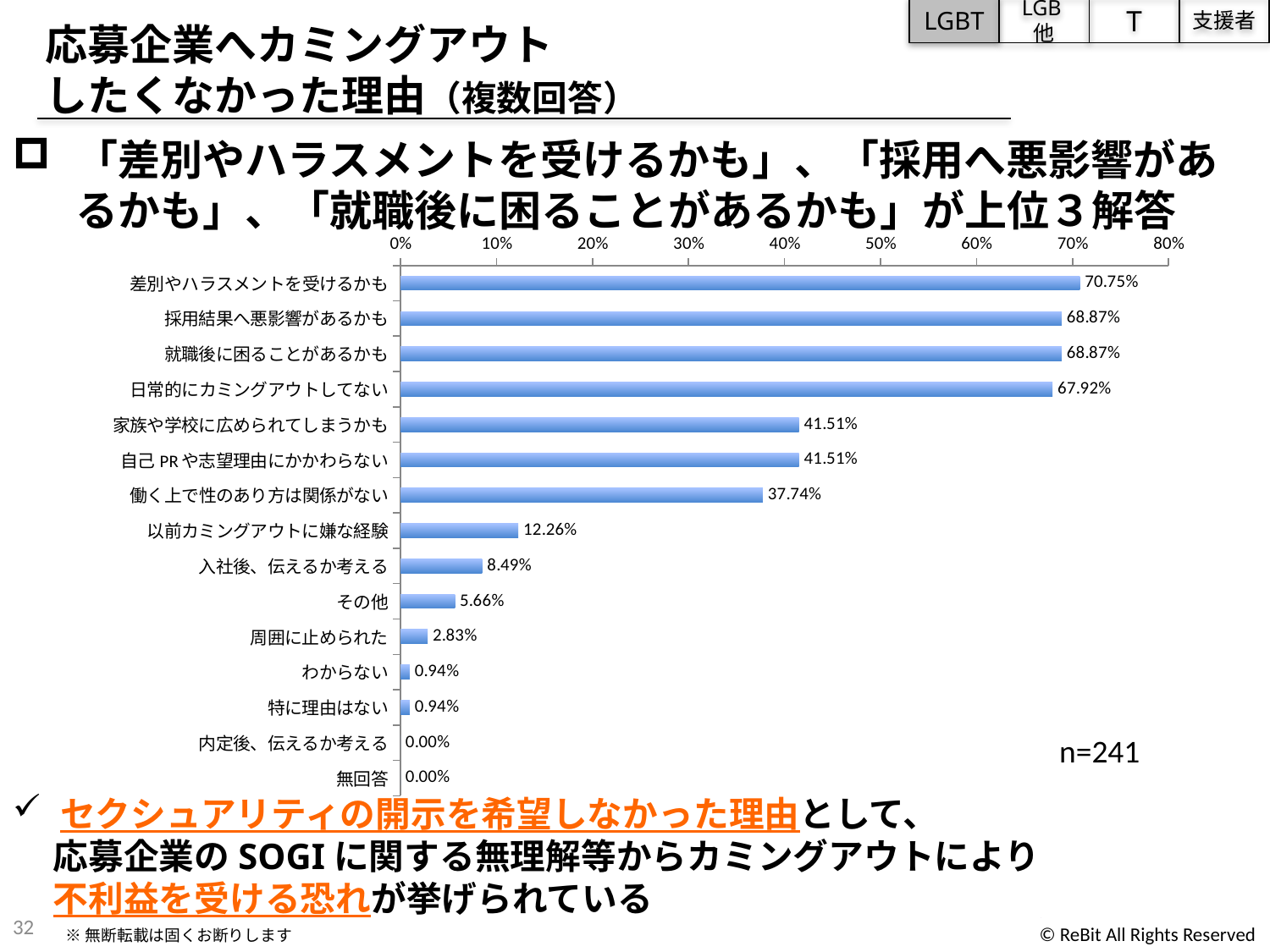
What sample size (n) is shown next to the chart? n=241 Is the value for 働く上で性のあり方は関係がない greater or less than 40%? less Which is larger, the value for 入社後、伝えるか考える or the value for その他? 入社後、伝えるか考える What is the difference between the values for 差別やハラスメントを受けるかも and 採用結果へ悪影響があるかも? 1.88 percentage points What is the value for 以前カミングアウトに嫌な経験? 12.26% What kind of chart is shown on the slide? bar chart How many categories are shown in the chart? 15 Which category has the highest value? 差別やハラスメントを受けるかも What is the difference between the values for 家族や学校に広められてしまうかも and 働く上で性のあり方は関係がない? 3.77 percentage points What is the value for 日常的にカミングアウトしてない? 67.92% What is the value for 差別やハラスメントを受けるかも? 70.75% What is the value for 周囲に止められた? 2.83%